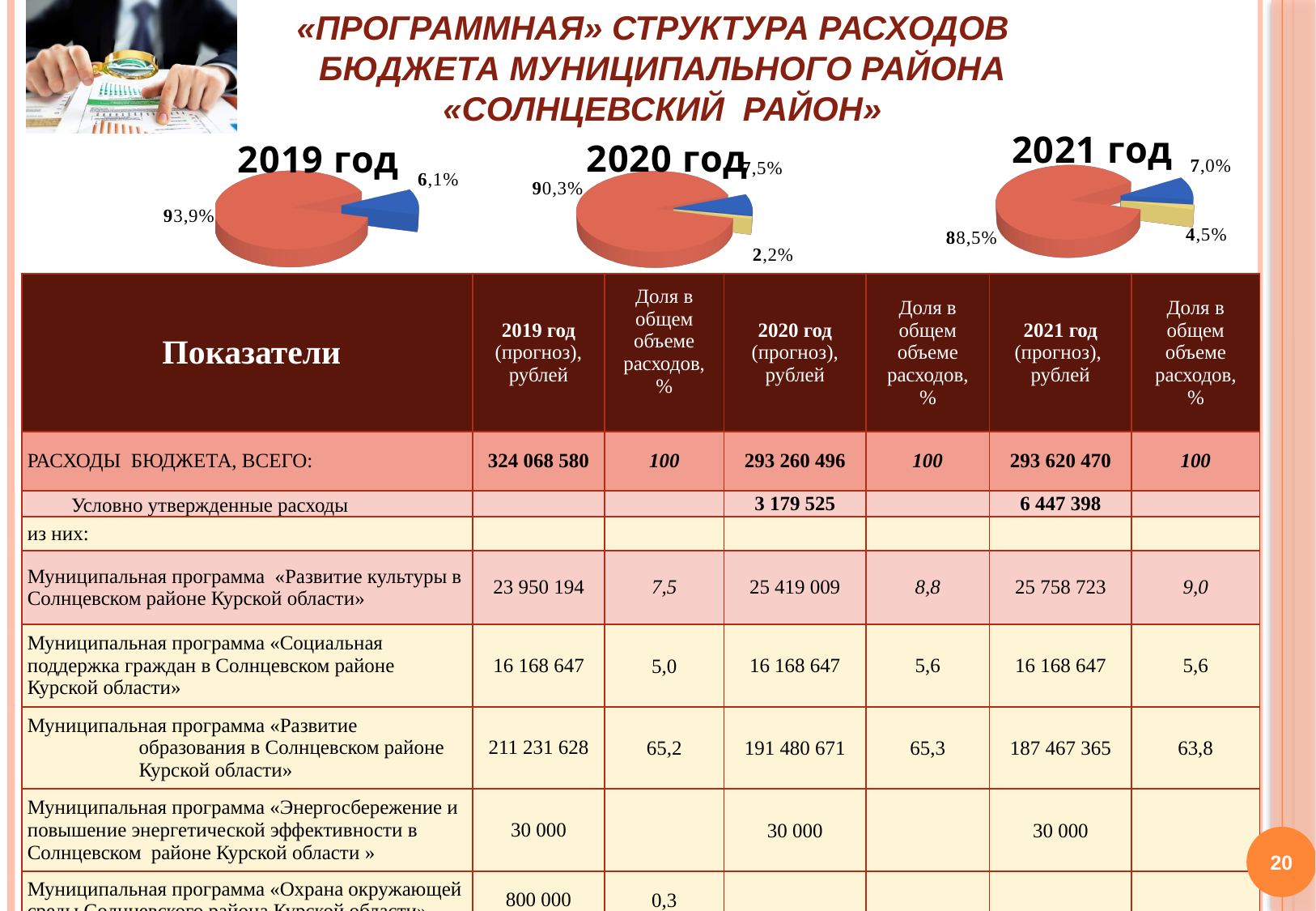
In the 2020 год pie chart, which slice is the smallest? The yellow slice (2,2%) In the 2020 год pie chart, what percentage is shown for the yellow slice? 2,2% How many slices does the 2021 год pie chart have? 3 In the 2019 год pie chart, what percentage is shown for the large red slice? 93,9% What is the difference between the red slice in the 2019 год pie chart (93,9%) and the red slice in the 2021 год pie chart (88,5%)? 5,4 percentage points In the 2021 год pie chart, which slice is the largest? The red slice (88,5%) In the 2019 год pie chart, what percentage is shown for the blue slice? 6,1% How many slices does the 2019 год pie chart have? 2 In the 2021 год pie chart, what percentage is shown for the yellow slice? 4,5% What kind of charts are shown at the top of the slide for 2019, 2020 and 2021? Pie charts In the 2020 год pie chart, what percentage is shown for the large red slice? 90,3% In the 2021 год pie chart, what percentage is shown for the blue slice? 7,0%